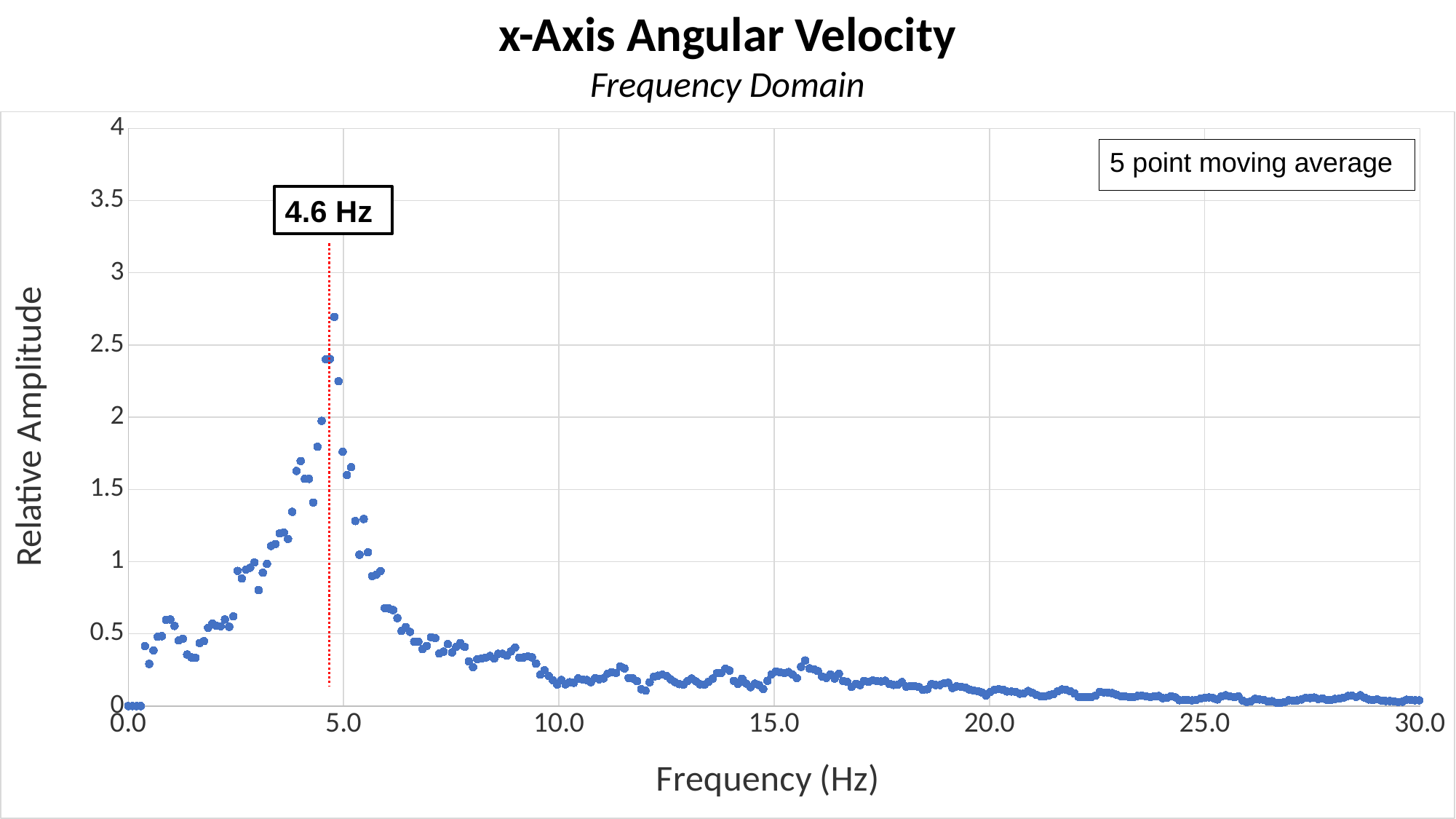
Is the highest relative amplitude value on the chart greater or less than 2.5? greater What kind of chart is shown on the slide? Scatter chart Which frequency has the larger relative amplitude, 4.6 Hz or 15.0 Hz? 4.6 Hz Do the relative amplitude values generally rise or fall as frequency increases from 5.0 Hz to 30.0 Hz? fall Is the relative amplitude at 10.0 Hz greater or less than 1? less Is the relative amplitude at 20.0 Hz greater or less than 0.5? less What is the subtitle shown under the chart title? Frequency Domain What is the title of the chart? x-Axis Angular Velocity What is the label of the x axis? Frequency (Hz) Do the relative amplitude values generally rise or fall as frequency increases from 0.0 Hz to 4.6 Hz? rise What is the maximum frequency shown on the x axis? 30.0 At what frequency does the annotated peak of the data occur? 4.6 Hz